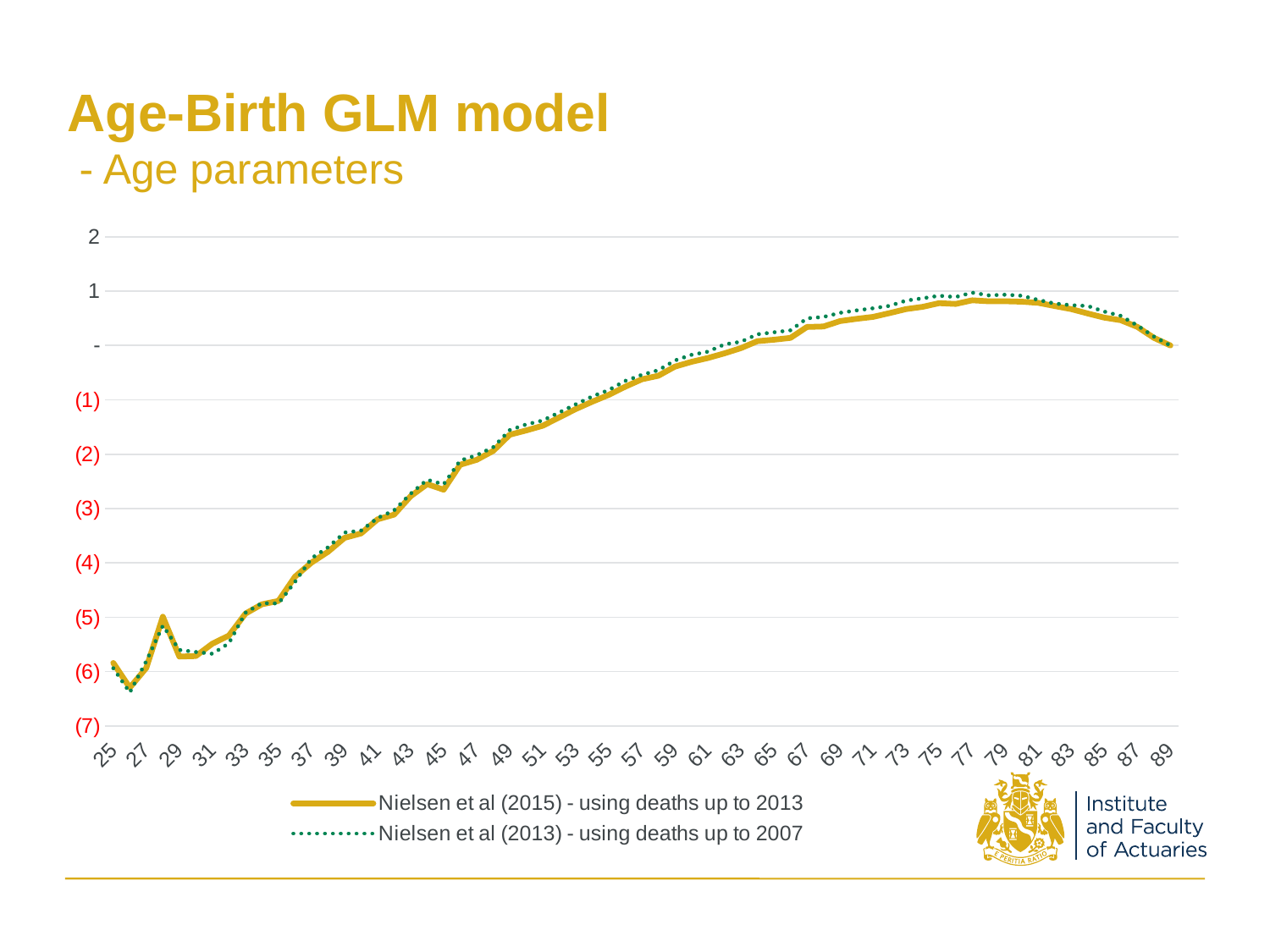
How many series does the legend list? 2 Is the value for age 75 in the Nielsen et al (2015) series greater or less than 0? greater What is the title of the slide's chart section? Age-Birth GLM model - Age parameters Is the value for age 53 in the Nielsen et al (2015) series greater or less than (1)? less Is the value for age 25 in the Nielsen et al (2015) series greater or less than (5)? less How many age labels are shown on the x axis? 33 What kind of chart is shown on the slide? line chart Which series is drawn as a dotted line? Nielsen et al (2013) - using deaths up to 2007 Do the age parameter values generally rise or fall from age 25 to age 75? rise